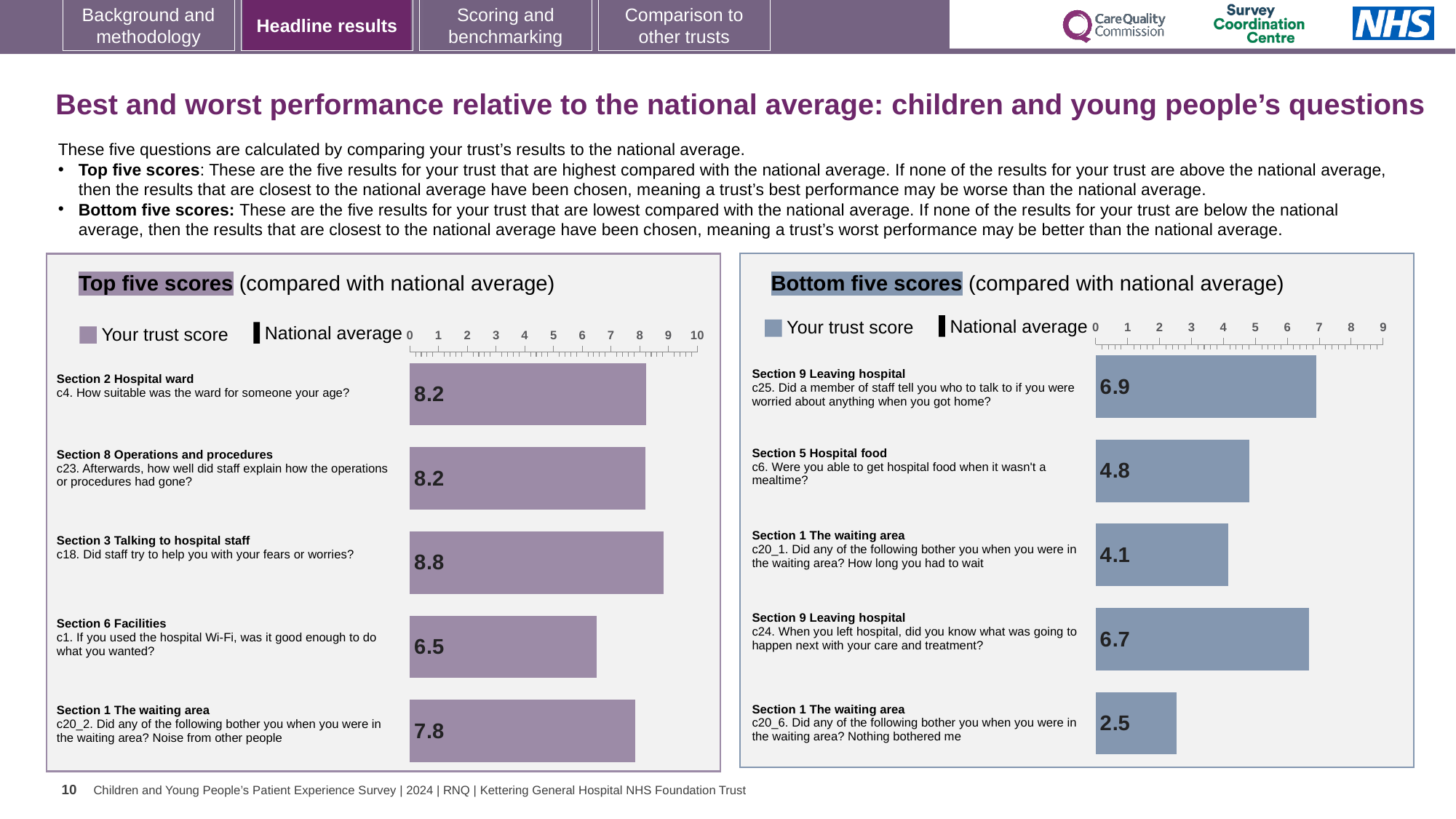
In the Top five scores chart, what is the difference between the scores for c18 and c20_2? 1.0 In the Bottom five scores chart, is the trust score for c25 or c24 larger? c25 In the Bottom five scores chart, which question has the highest trust score? c25. Did a member of staff tell you who to talk to if you were worried about anything when you got home? In the Top five scores chart, what is the trust score for c1 about hospital Wi-Fi? 6.5 What type of chart is used in the Top five scores panel? Bar chart In the Top five scores chart, which question has the lowest trust score? c1. If you used the hospital Wi-Fi, was it good enough to do what you wanted? In the Top five scores chart, which question has the highest trust score? c18. Did staff try to help you with your fears or worries? In the Bottom five scores chart, what is the difference between the scores for c6 and c20_1? 0.7 In the Bottom five scores chart, which question has the lowest trust score? c20_6. Did any of the following bother you when you were in the waiting area? Nothing bothered me In the Top five scores chart, what is the trust score for c18 'Did staff try to help you with your fears or worries?' 8.8 In the Top five scores chart, how many questions are plotted? 5 In the Bottom five scores chart, what is the trust score for c6 'Were you able to get hospital food when it wasn't a mealtime?' 4.8